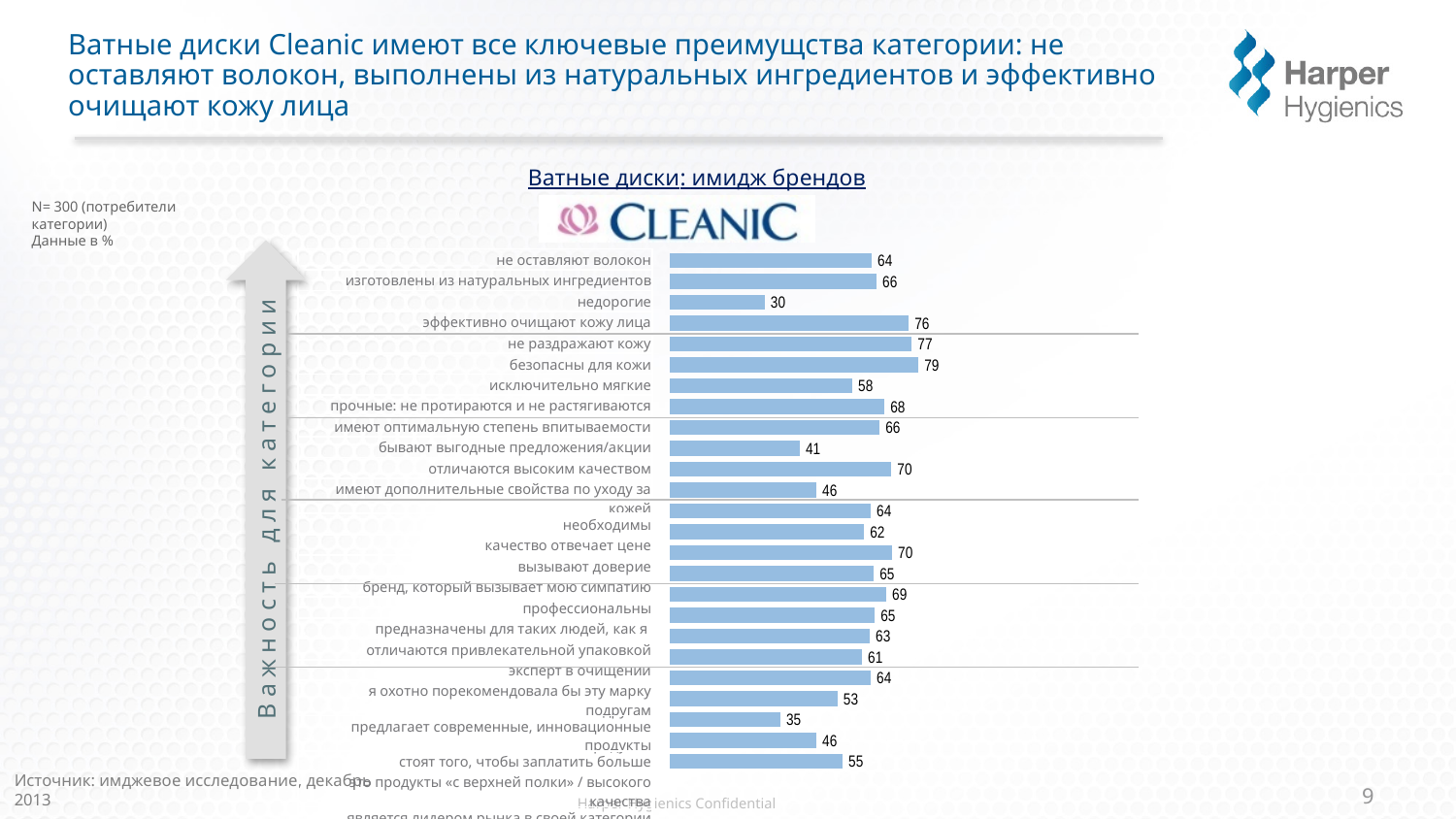
What is the title of the chart? Ватные диски: имидж брендов What is the value for "бывают выгодные предложения/акции"? 41 Which category has the highest value? безопасны для кожи Which category has the lowest value? недорогие What is the difference between the values for "не раздражают кожу" and "исключительно мягкие"? 19 What type of chart is shown on the slide? bar chart What is the value for "эффективно очищают кожу лица"? 76 What is the value for "безопасны для кожи"? 79 What is the difference between the values for "безопасны для кожи" and "недорогие"? 49 What is the value for "недорогие"? 30